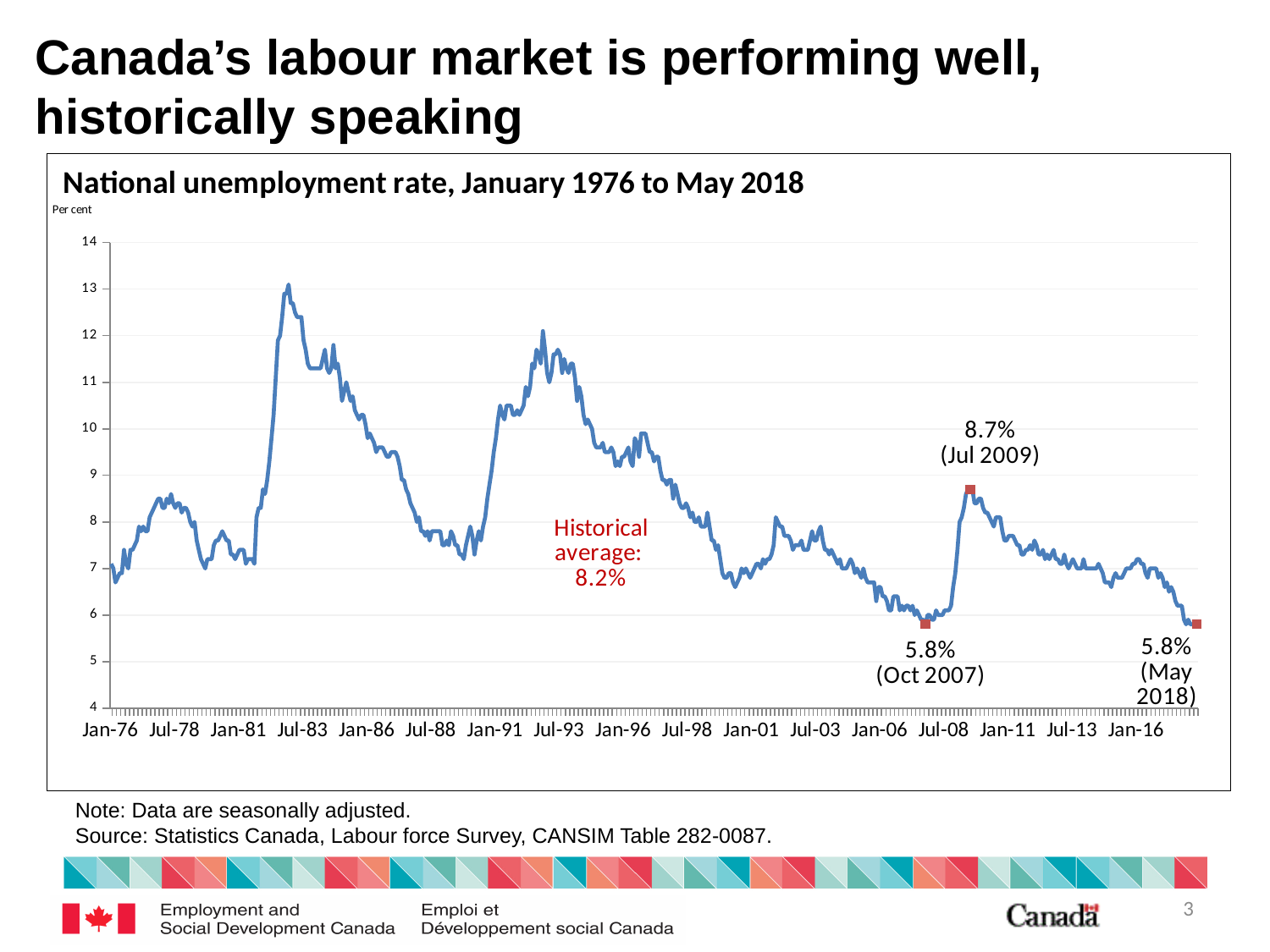
What was the national unemployment rate in July 2009, as labelled on the chart? 8.7% Is the unemployment rate at Jan-76 greater or less than 8? less What was the national unemployment rate in October 2007, as labelled on the chart? 5.8% Is the unemployment rate at its peak near Jul-83 greater or less than 12? greater Which labelled point is higher: July 2009 or May 2018? July 2009 Does the unemployment rate generally rise or fall between July 2009 and May 2018? Fall Near which x-axis label does the line reach its highest point? Jul-83 What was the national unemployment rate in May 2018, as labelled on the chart? 5.8% What type of chart is shown on the slide? Line chart What is the title of the chart? National unemployment rate, January 1976 to May 2018 By how many percentage points does the July 2009 rate exceed the October 2007 rate? 2.9 What historical average unemployment rate is noted on the chart? 8.2%